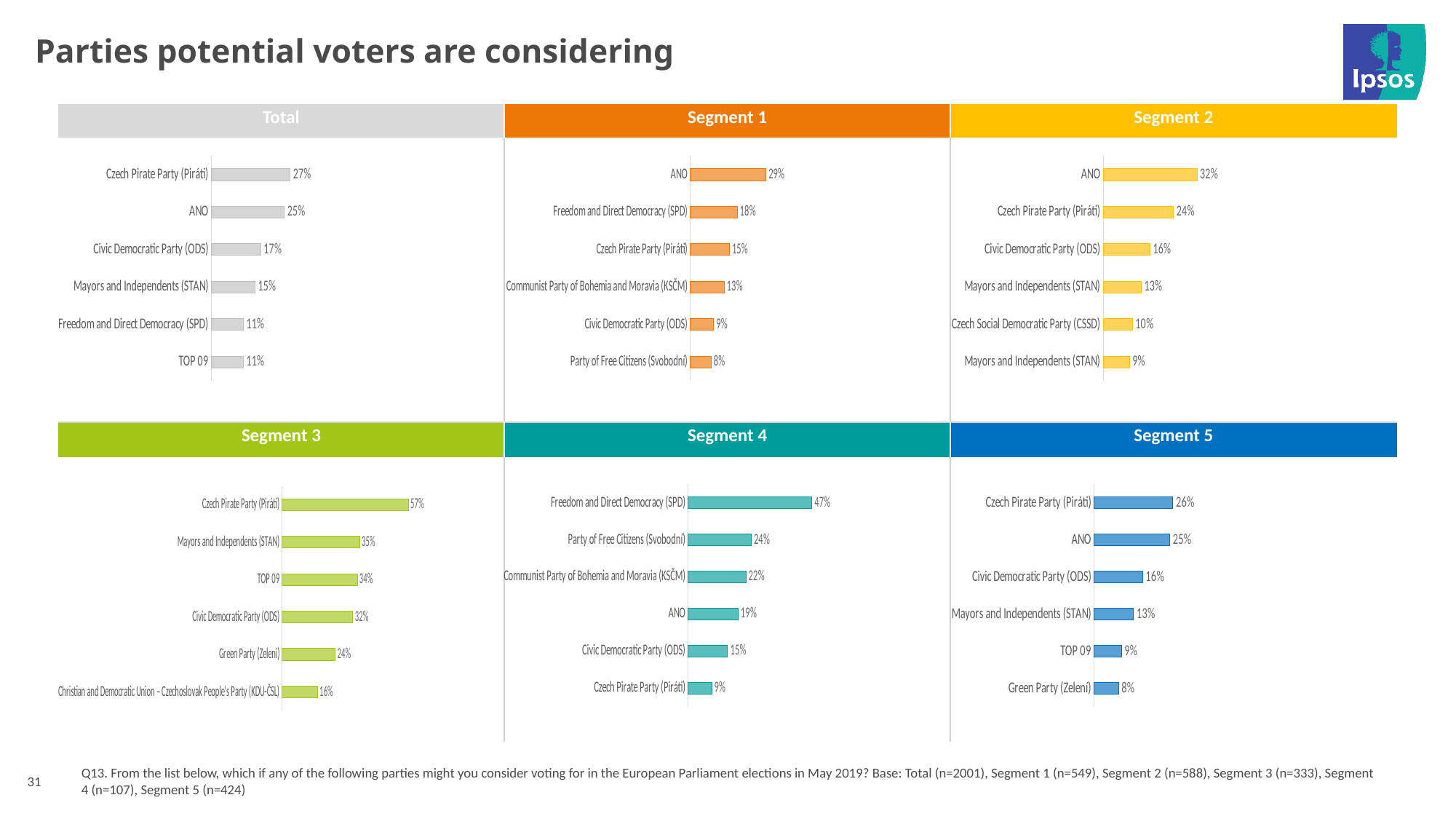
In the Segment 4 chart, which is larger: Freedom and Direct Democracy (SPD) or Party of Free Citizens (Svobodní)? Freedom and Direct Democracy (SPD) In the Segment 1 chart, what is the value for Communist Party of Bohemia and Moravia (KSČM)? 13% In the Segment 1 chart, which party has the highest value? ANO In the Segment 2 chart, what is the difference between ANO and Civic Democratic Party (ODS)? 16% In the Segment 4 chart, which party has the lowest value? Czech Pirate Party (Piráti) In the Total chart, what is the value for ANO? 25% What kind of chart is the Total chart? Bar chart In the Segment 2 chart, what is the value for Czech Pirate Party (Piráti)? 24% How many charts are shown on the slide? 6 How many parties are shown in the Segment 3 chart? 6 In the Segment 5 chart, what is the difference between Czech Pirate Party (Piráti) and Green Party (Zelení)? 18% In the Segment 3 chart, what is the value for Czech Pirate Party (Piráti)? 57%